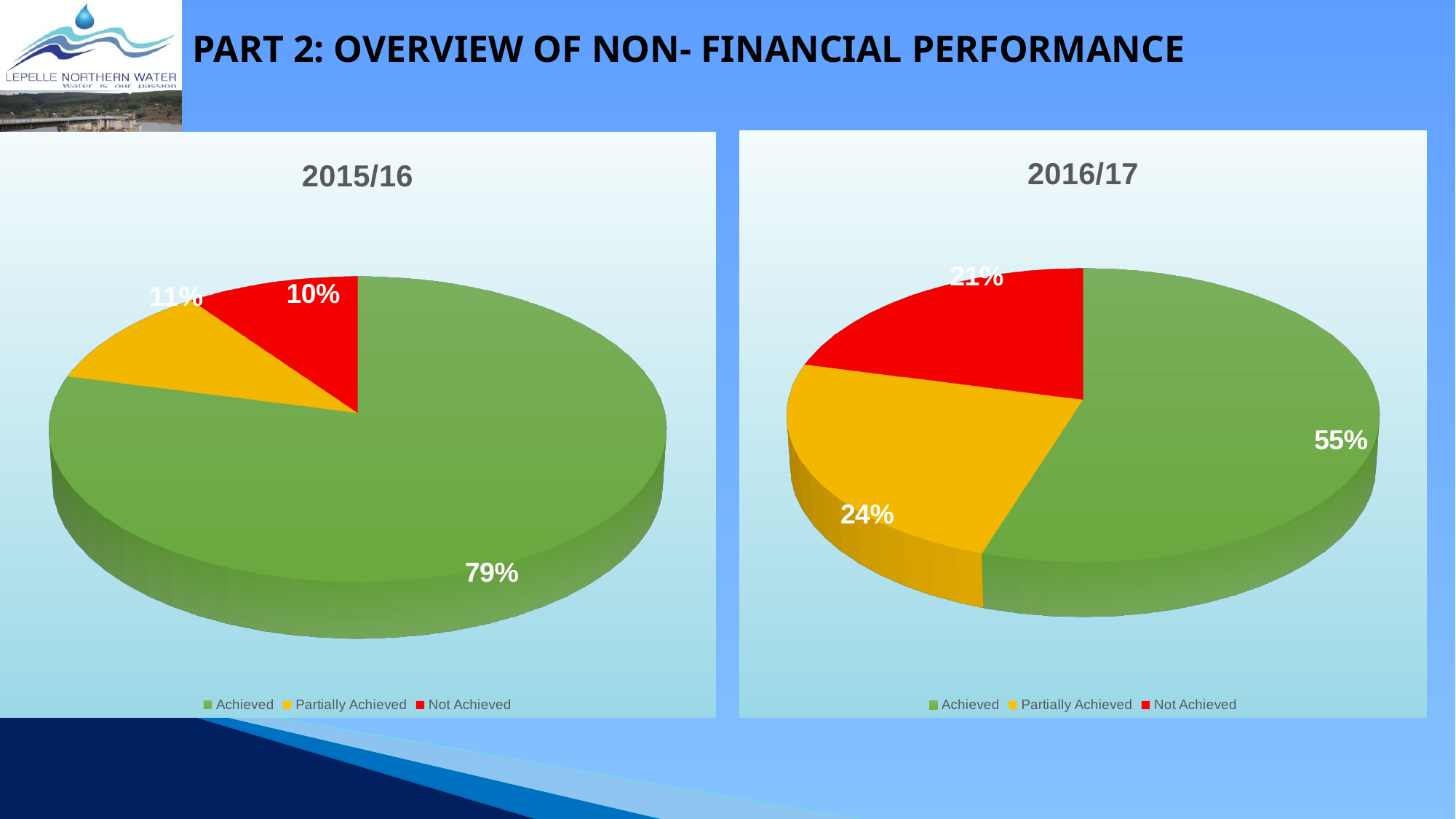
In the 2016/17 chart, which is larger: Partially Achieved or Not Achieved? Partially Achieved In the 2016/17 chart, what percentage is labelled for Not Achieved? 21% In the 2016/17 chart, what percentage is labelled for Achieved? 55% What type of chart is the 2015/16 chart? Pie chart What is the difference between the Achieved percentage in the 2015/16 chart and the Achieved percentage in the 2016/17 chart? 24% In the 2015/16 chart, what percentage is labelled for Achieved? 79% In the 2015/16 chart, what percentage is labelled for Partially Achieved? 11% In the 2015/16 chart, which category has the smallest slice? Not Achieved In the 2015/16 chart, what percentage is labelled for Not Achieved? 10% How many entries does the legend of the 2016/17 chart list? 3 In the 2016/17 chart, what percentage is labelled for Partially Achieved? 24% In the 2016/17 chart, which category has the largest slice? Achieved